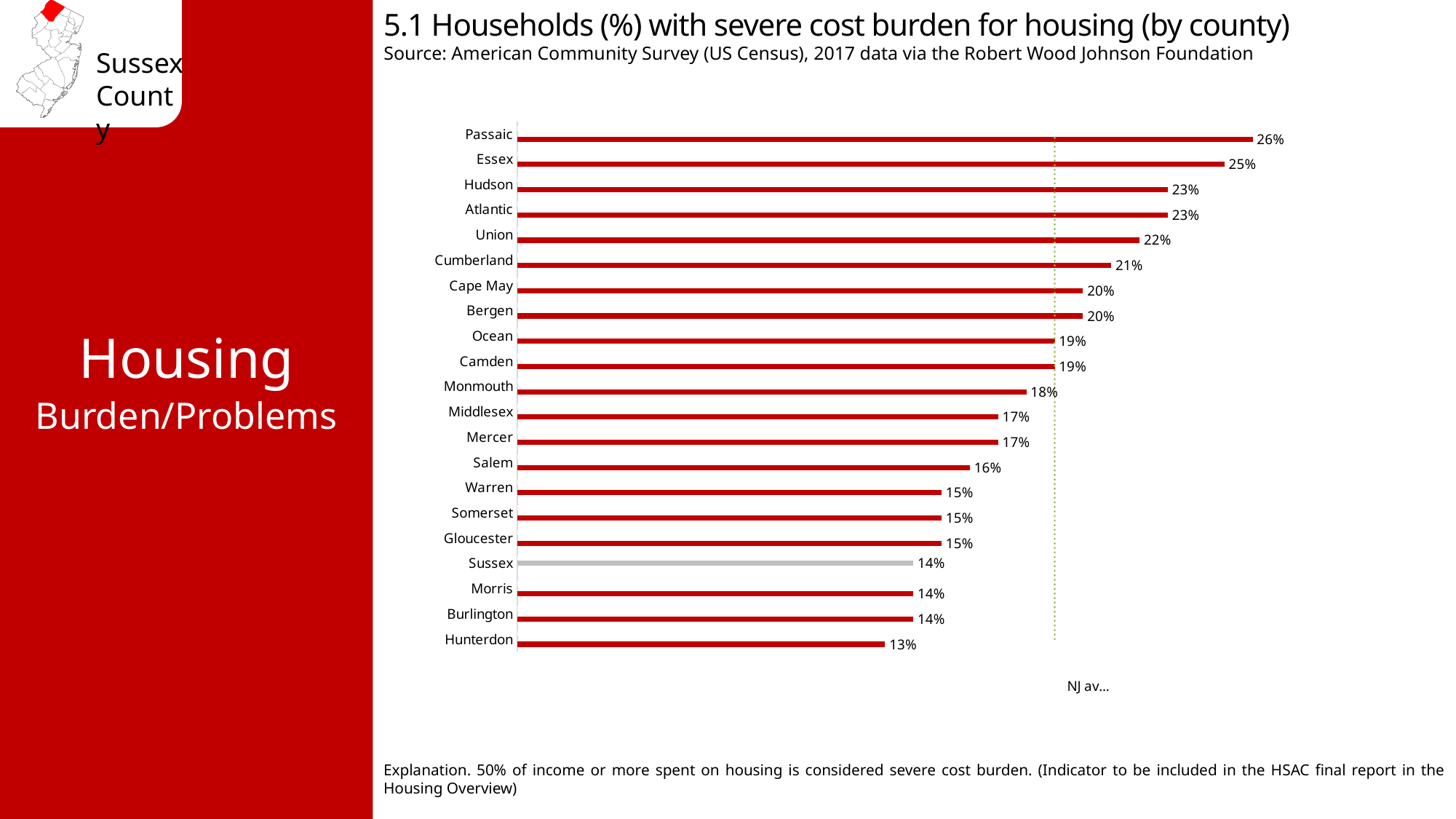
What is the value shown for Sussex County? 14% Which has a higher value, Bergen or Salem? Bergen Which county has the lowest percentage of households with severe housing cost burden? Hunterdon What type of chart is used on this slide? Bar chart Which has a higher value, Monmouth or Warren? Monmouth What is the difference in percentage points between Passaic and Sussex? 12 percentage points How many counties are shown in the chart? 21 Which county's bar is shown in grey instead of red? Sussex What is the value shown for Cumberland County? 21% What percentage of households in Passaic County have a severe housing cost burden? 26% Which county has the highest percentage of households with severe housing cost burden? Passaic What is the difference in percentage points between Essex and Hunterdon? 12 percentage points